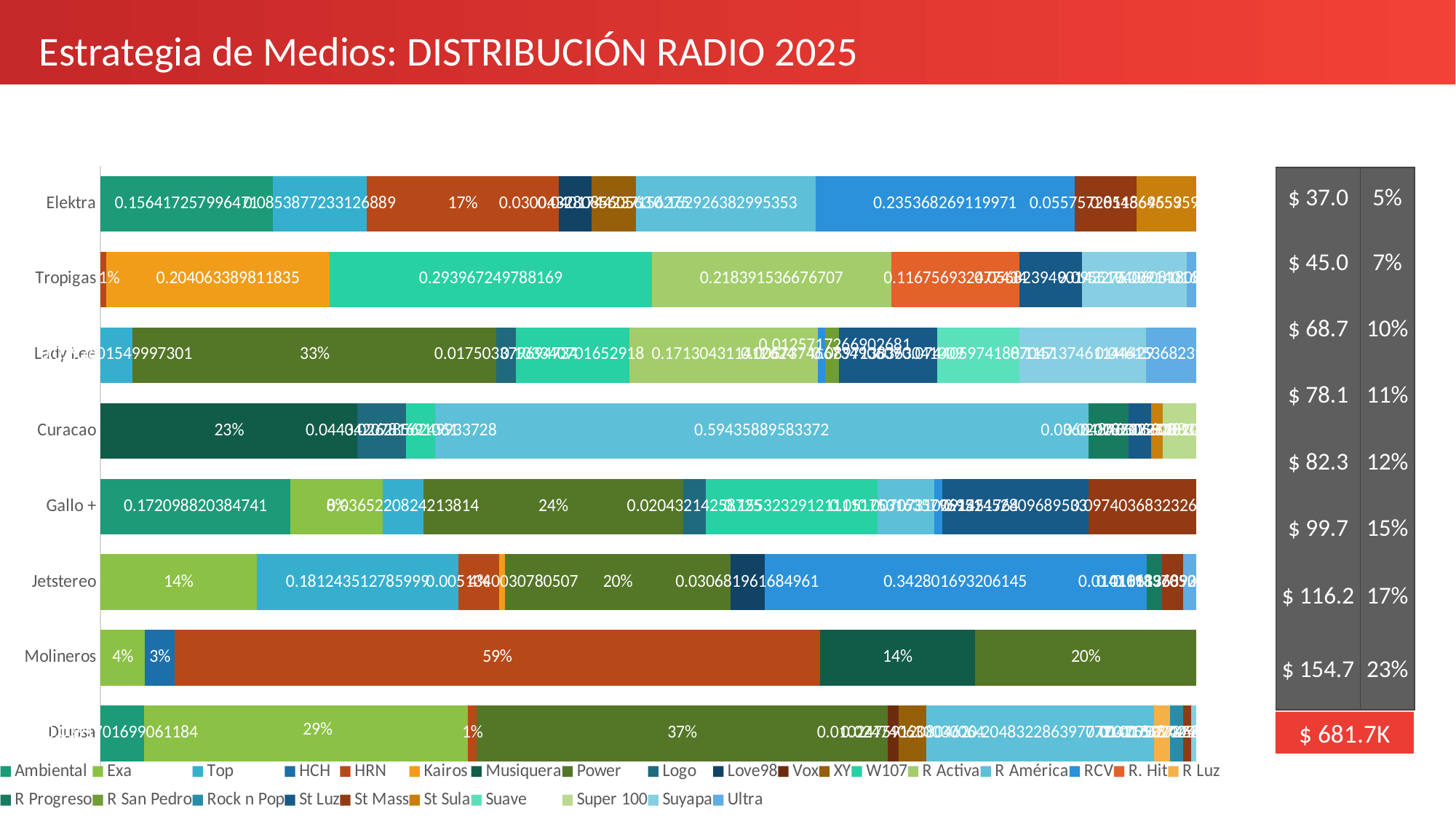
What is the value of the Power segment in the Molineros bar? 20% How many series does the chart legend list? 28 What is the value of the Exa segment in the Molineros bar? 4% In the Molineros bar, what is the difference between the HRN segment (59%) and the Power segment (20%)? 39 percentage points What type of chart is shown on the slide? Stacked bar chart What is the value of the largest labeled segment in the Curacao bar? 0.59435889583372 What is the value of the HRN segment in the Molineros bar? 59% Which series has the largest share in the Molineros bar? HRN In the Molineros bar, which is larger: the HRN segment or the Musiquera segment? HRN How many categories (retailers) are plotted on the vertical axis of the chart? 8 What total value is shown in the red box at the bottom of the table on the right of the slide? $ 681.7K What is the value of the largest labeled segment in the Diunsa bar? 37%